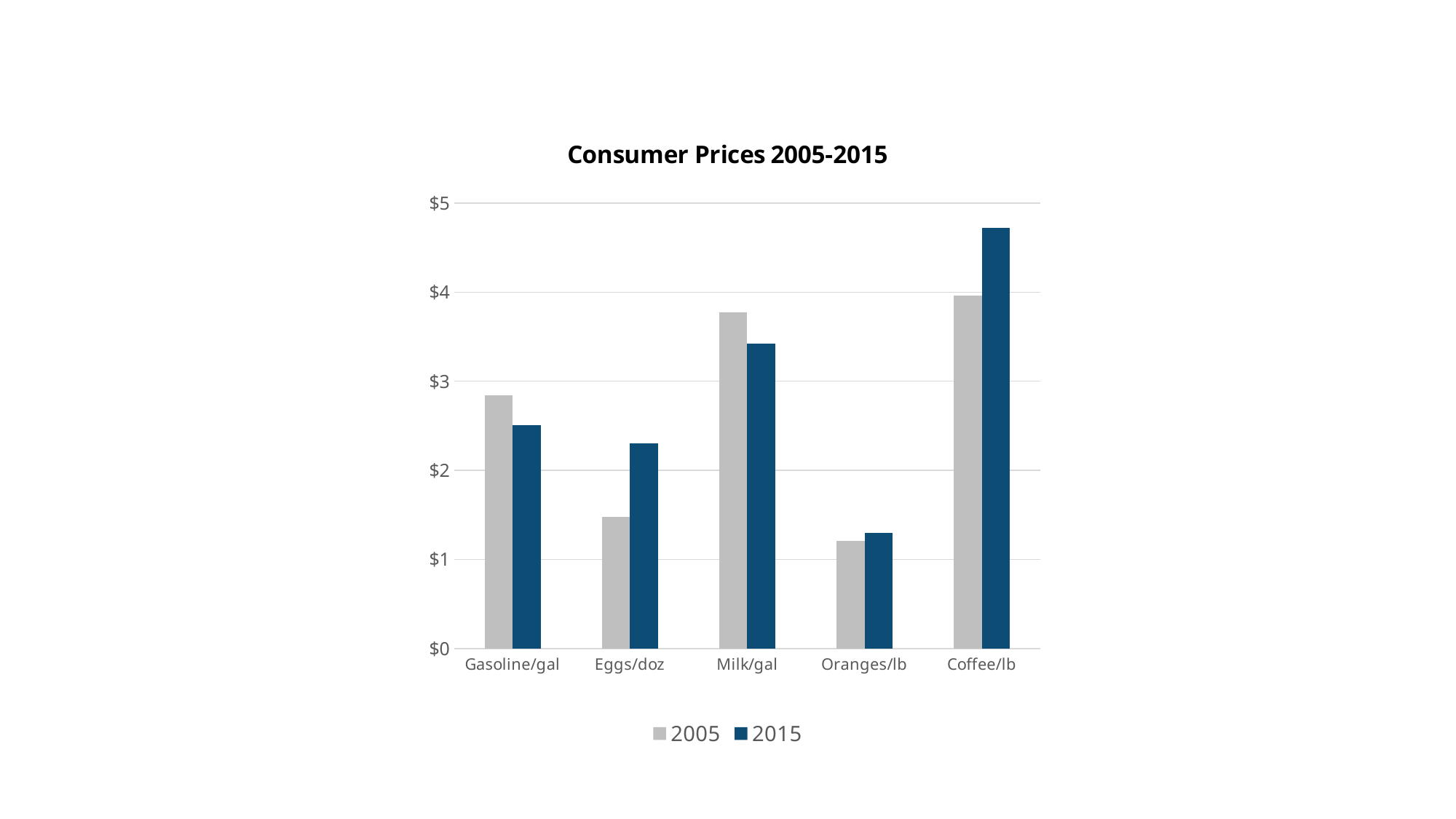
What kind of chart is shown on the slide? bar chart How many series does the legend list? 2 Is the 2005 value for Eggs/doz greater or less than $2? less For Gasoline/gal, which year has the larger value, 2005 or 2015? 2005 How many product categories are shown on the x axis? 5 For Eggs/doz, which year has the larger value, 2005 or 2015? 2015 Which category has the highest 2015 price? Coffee/lb Is the 2015 value for Coffee/lb greater or less than $4? greater Is the 2005 value for Gasoline/gal greater or less than $3? less What is the title of the chart? Consumer Prices 2005-2015 Which category has the lowest 2005 price? Oranges/lb